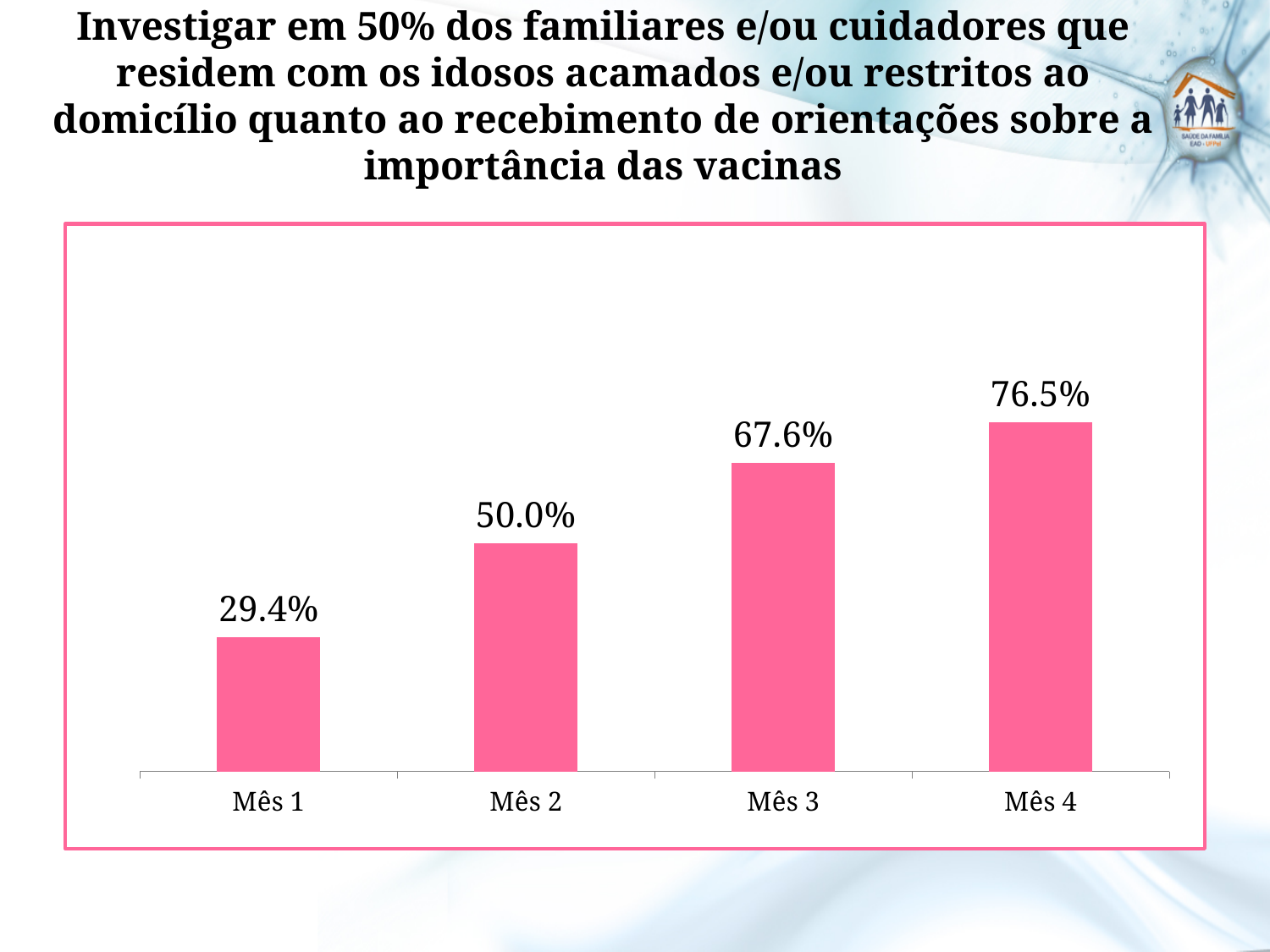
What kind of chart is shown on the slide? Bar chart What is the value for Mês 4? 76.5% What is the value for Mês 3? 67.6% What is the difference between the values for Mês 4 and Mês 1? 47.1% Which is larger, the value for Mês 2 or the value for Mês 3? Mês 3 What is the value for Mês 2? 50.0% What is the value for Mês 1? 29.4% What is the difference between the values for Mês 3 and Mês 2? 17.6% Do the values rise or fall from Mês 1 to Mês 4? Rise Which month has the highest value? Mês 4 How many months are shown on the x axis? 4 Which month has the lowest value? Mês 1